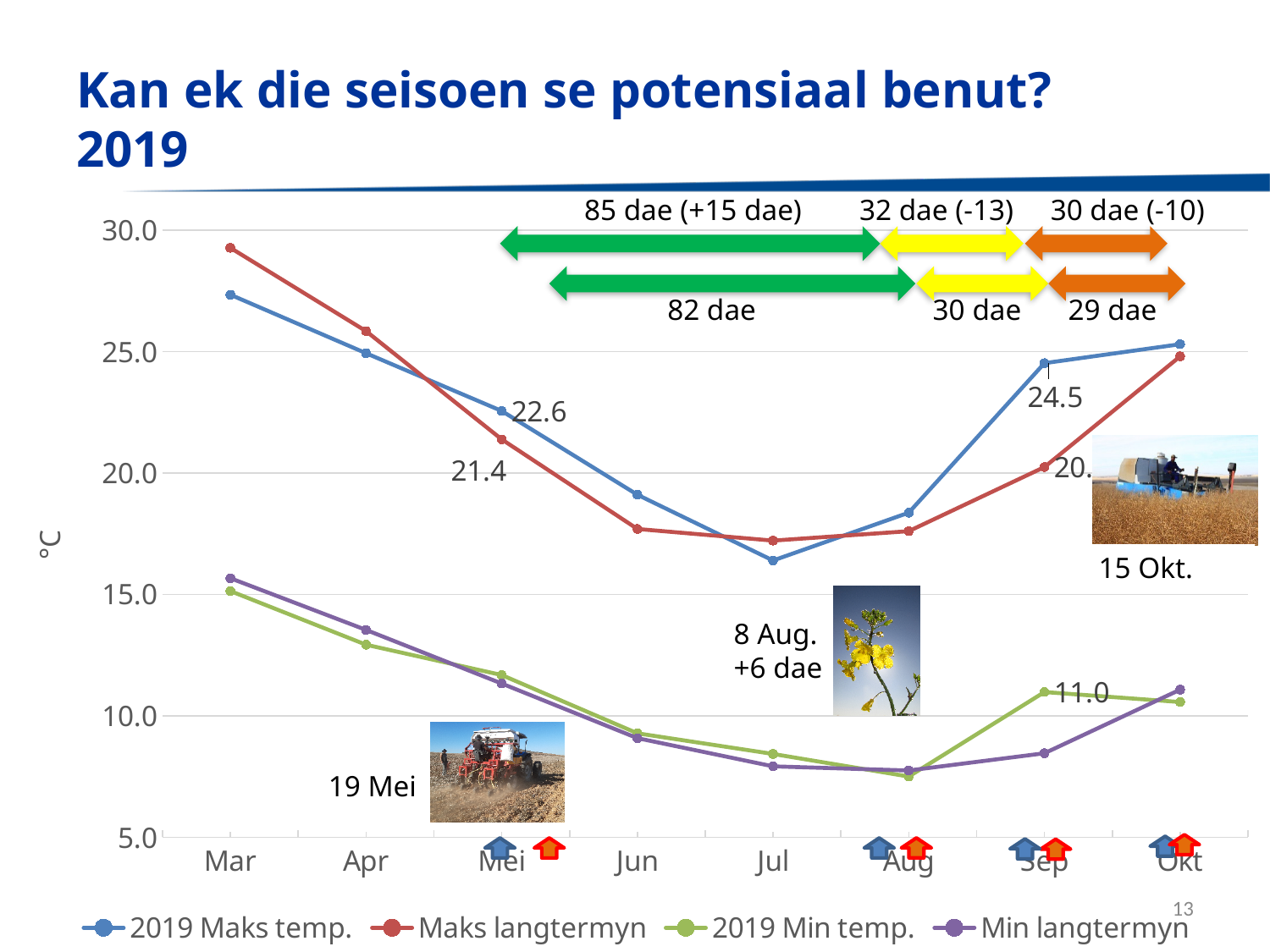
In which month is 2019 Maks temp. highest? Mar What is the value of 2019 Maks temp. in Mei? 22.6 How many series does the legend list? 4 What is the value of 2019 Min temp. in Sep? 11.0 How many months are shown on the x axis? 8 What is the value of Maks langtermyn in Mei? 21.4 What kind of chart is shown on the slide? line chart In Mei, which is higher: 2019 Maks temp. or Maks langtermyn? 2019 Maks temp. What is the value of 2019 Maks temp. in Sep? 24.5 In Mei, what is the difference between 2019 Maks temp. and Maks langtermyn? 1.2 Is the value for 2019 Maks temp. in Jul greater or less than 20.0? less Does 2019 Maks temp. rise or fall from Mar to Jul? fall